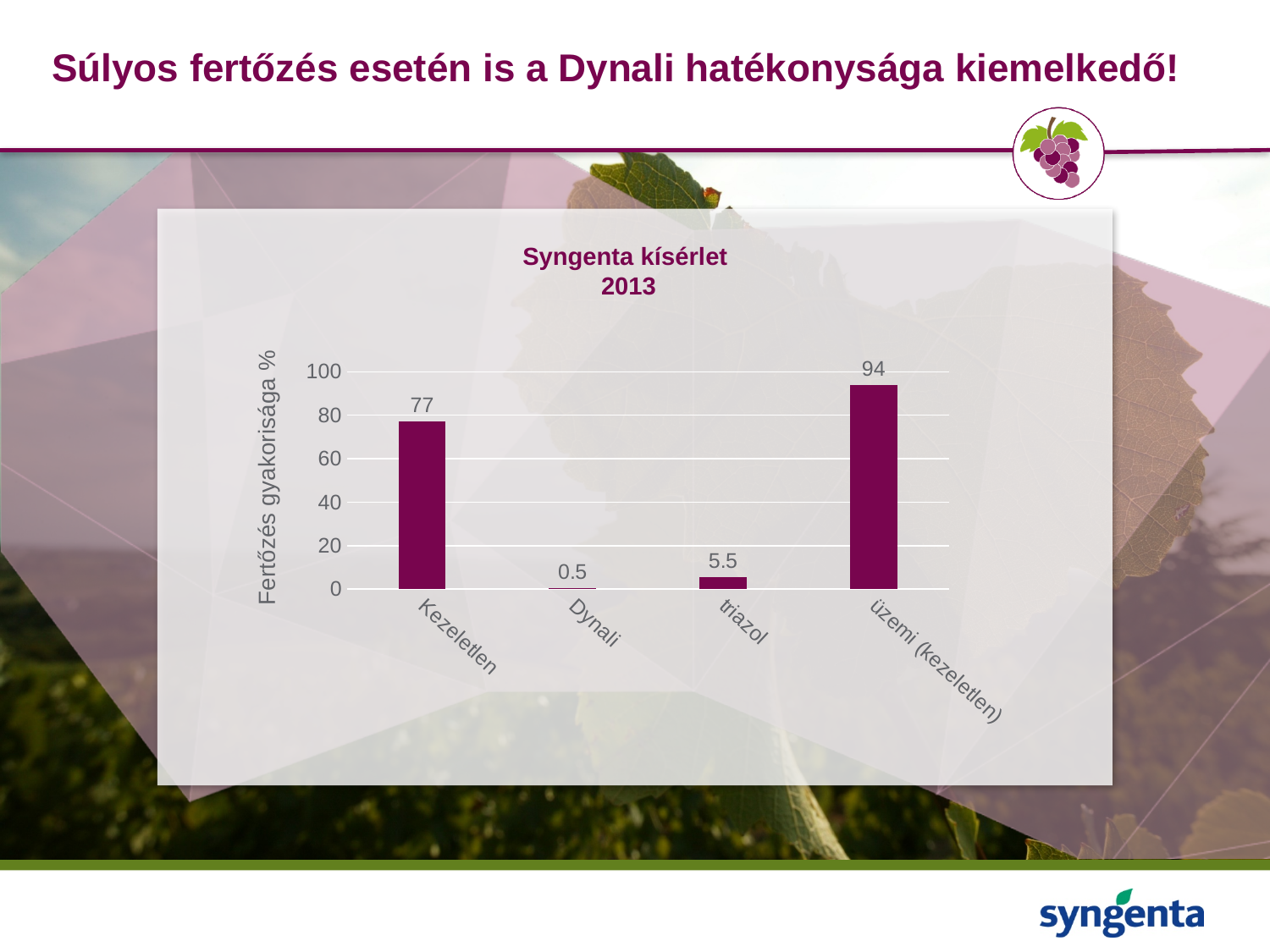
Which is larger, the value for triazol or the value for Dynali? triazol What is the difference between the values for triazol and Dynali? 5 Which category has the lowest value? Dynali What is the value for Dynali? 0.5 What is the difference between the values for üzemi (kezeletlen) and Kezeletlen? 17 How many categories are shown on the x axis? 4 Which category has the highest value? üzemi (kezeletlen) What is the value for triazol? 5.5 What is the value for üzemi (kezeletlen)? 94 What is the value for Kezeletlen? 77 What kind of chart is shown? bar chart What is the title of the chart? Syngenta kísérlet 2013